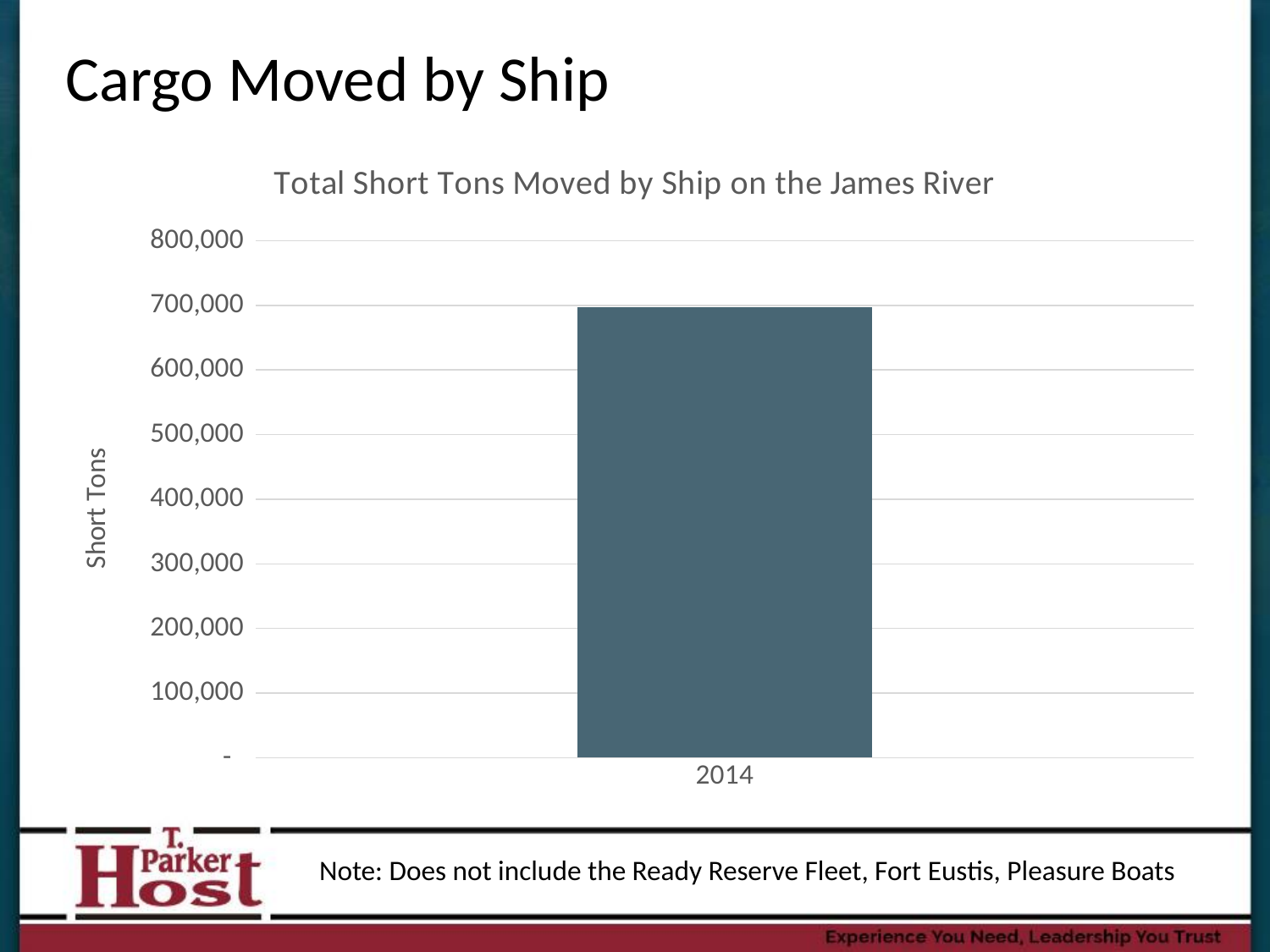
Is the value for 2014 greater or less than 800,000? less How many categories are plotted on the x axis of the chart? 1 What kind of chart is shown on the slide? bar chart What is the title of the chart? Total Short Tons Moved by Ship on the James River Is the value for 2014 greater or less than 400,000? greater Is the value for 2014 greater or less than 600,000? greater Which year is shown on the x axis of the chart? 2014